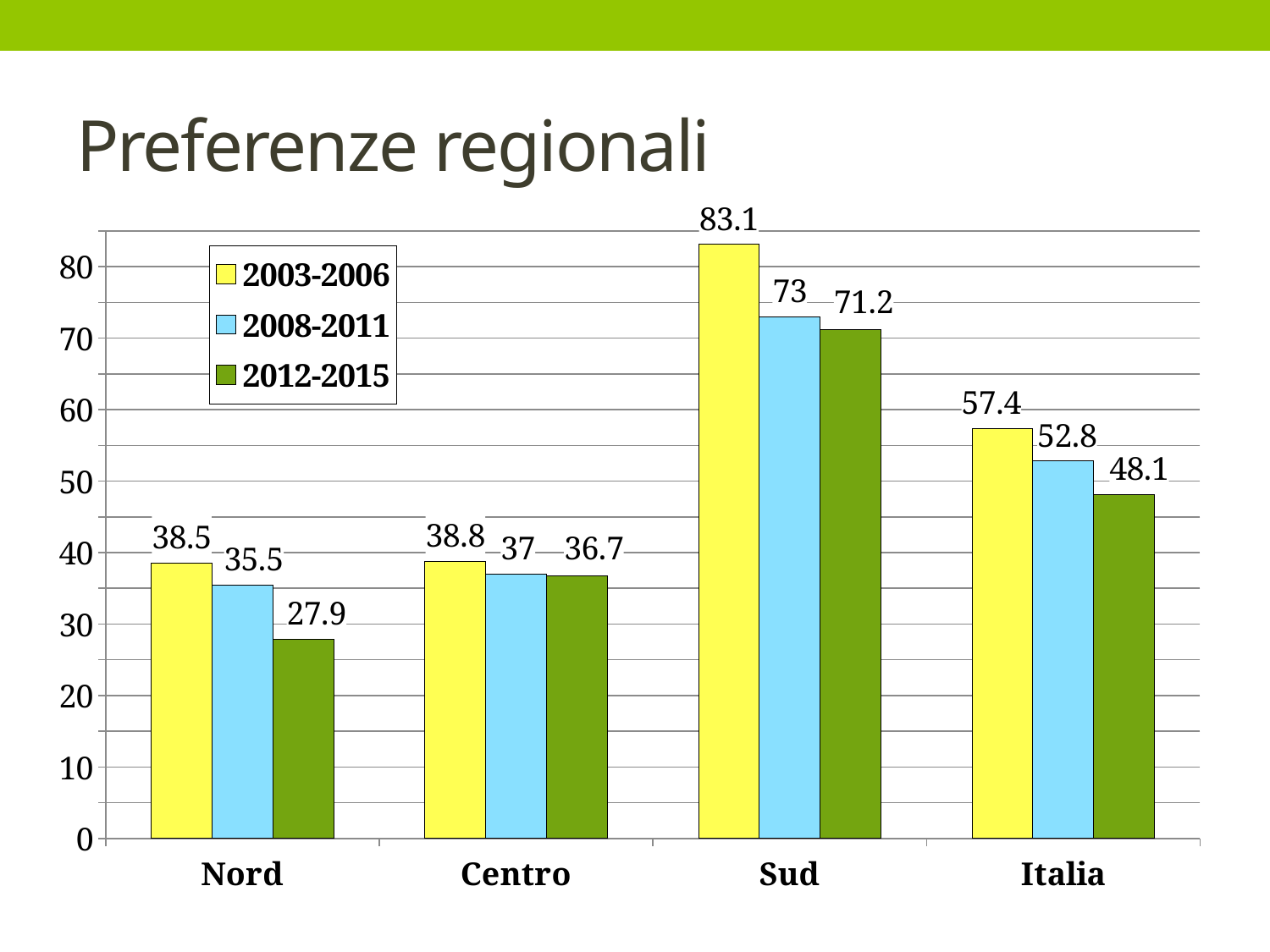
Do the values for Italia rise or fall from the 2003-2006 series to the 2012-2015 series? Fall Which region has the lowest value in the 2012-2015 series? Nord What kind of chart is shown on the slide? Bar chart How many series does the legend list? 3 What is the value for Italia in the 2008-2011 series? 52.8 How many regions are shown on the x axis? 4 What is the value for Nord in the 2012-2015 series? 27.9 What is the difference between the 2003-2006 and 2008-2011 values for Italia? 4.6 Which region has the highest value in the 2003-2006 series? Sud What is the difference between the 2003-2006 and 2012-2015 values for Sud? 11.9 Which is larger: the 2008-2011 value for Centro or the 2008-2011 value for Nord? Centro What is the value for Sud in the 2003-2006 series? 83.1